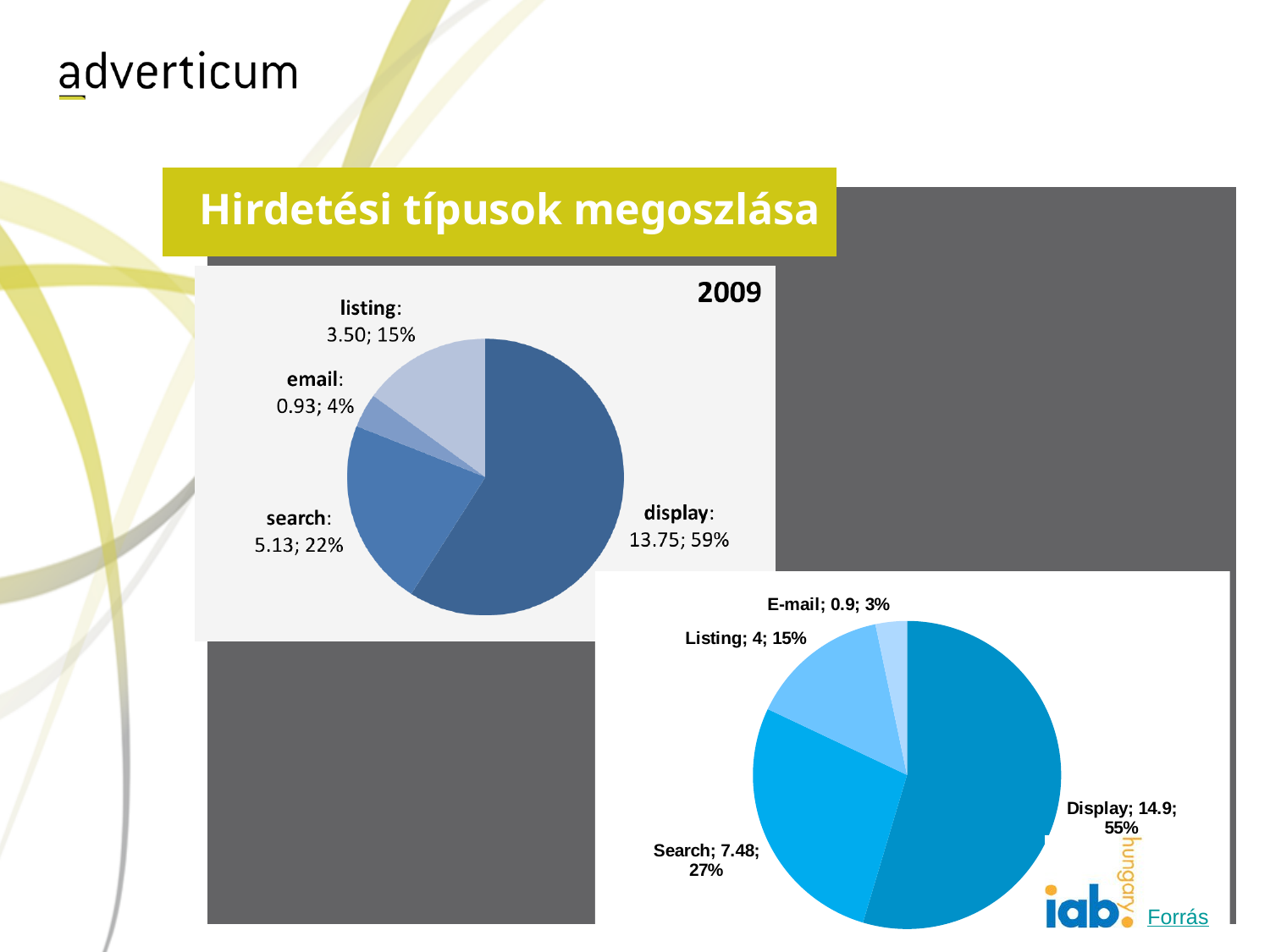
In the 2009 pie chart, which category has the smallest slice? email In the bottom-right pie chart, what share does E-mail have? 3% In the bottom-right pie chart, what value and share are shown for Search? 7.48; 27% In the 2009 pie chart, what share does search have? 22% In the bottom-right pie chart, which category has the largest slice? Display What is the title shown above the charts on the slide? Hirdetési típusok megoszlása In the 2009 pie chart, what value and share are shown for display? 13.75; 59% In the 2009 pie chart, what is the difference between the display value and the search value? 8.62 In the 2009 pie chart, how many categories are shown? 4 In the 2009 pie chart, which category has the largest slice? display What type of chart is used on this slide? Pie chart In the bottom-right pie chart, which is larger, Listing or Search? Search